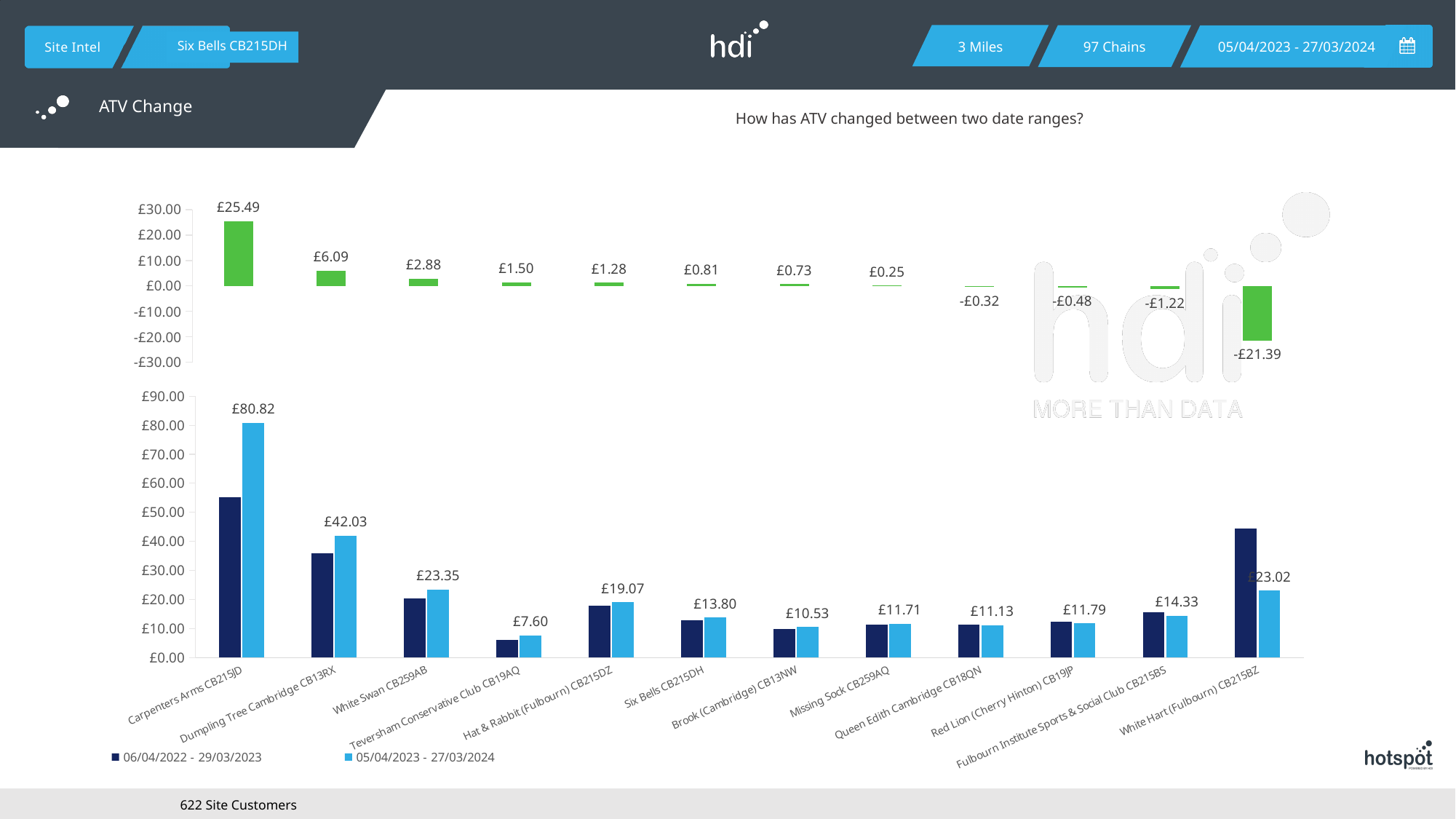
In the bottom chart, which category has the highest value in the 05/04/2023 - 27/03/2024 series? Carpenters Arms CB215JD In the top chart, what is the highest value shown? £25.49 In the bottom chart, what is the value for Six Bells CB215DH in the 05/04/2023 - 27/03/2024 series? £13.80 In the bottom chart, which category has the lowest value in the 05/04/2023 - 27/03/2024 series? Teversham Conservative Club CB19AQ In the bottom chart, what is the value for Carpenters Arms CB215JD in the 05/04/2023 - 27/03/2024 series? £80.82 How many series does the legend of the bottom chart list? 2 How many categories are shown on the x axis of the bottom chart? 12 In the bottom chart, what is the difference between the 05/04/2023 - 27/03/2024 values for Dumpling Tree Cambridge CB13RX and White Swan CB259AB? £18.68 In the bottom chart, which is larger in the 05/04/2023 - 27/03/2024 series: White Hart (Fulbourn) CB215BZ or Fulbourn Institute Sports & Social Club CB215BS? White Hart (Fulbourn) CB215BZ In the top chart, what is the lowest value shown? -£21.39 What kind of chart is the bottom chart on the slide? bar chart In the bottom chart, is the 06/04/2022 - 29/03/2023 value for Carpenters Arms CB215JD greater or less than £50.00? greater